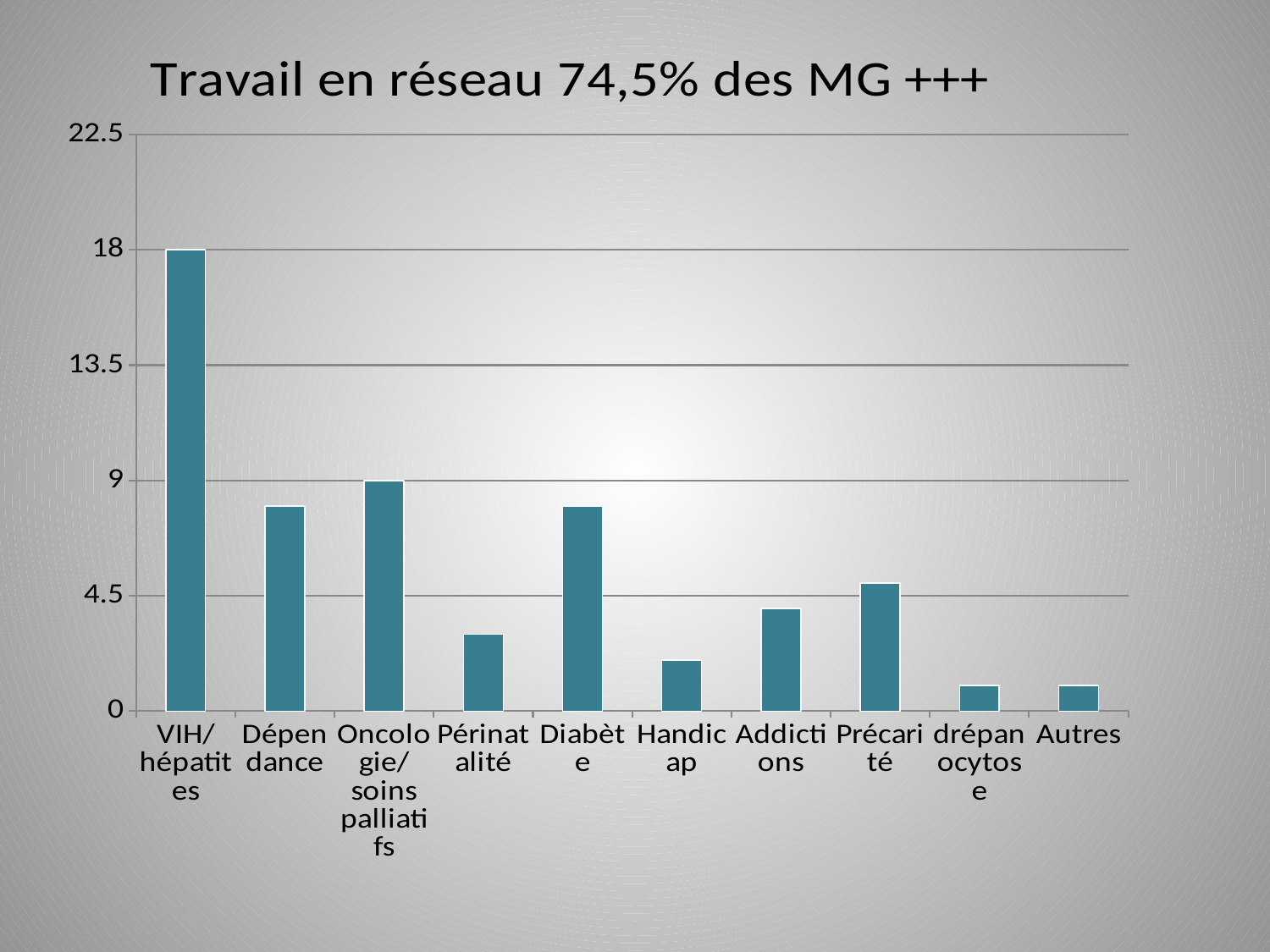
What is the value for Oncologie/soins palliatifs? 9 Is the value for Dépendance greater or less than 4.5? greater What is the difference between the values for VIH/hépatites and Oncologie/soins palliatifs? 9 What kind of chart is shown on the slide? bar chart Which is larger, the value for Précarité or the value for Handicap? Précarité How many categories are shown on the x axis? 10 Is the value for Addictions greater or less than 4.5? less Which category has the highest value? VIH/hépatites What is the title of the chart? Travail en réseau 74,5% des MG +++ What is the value for VIH/hépatites? 18 Which is larger, the value for Diabète or the value for Périnatalité? Diabète Is the value for Diabète greater or less than 9? less